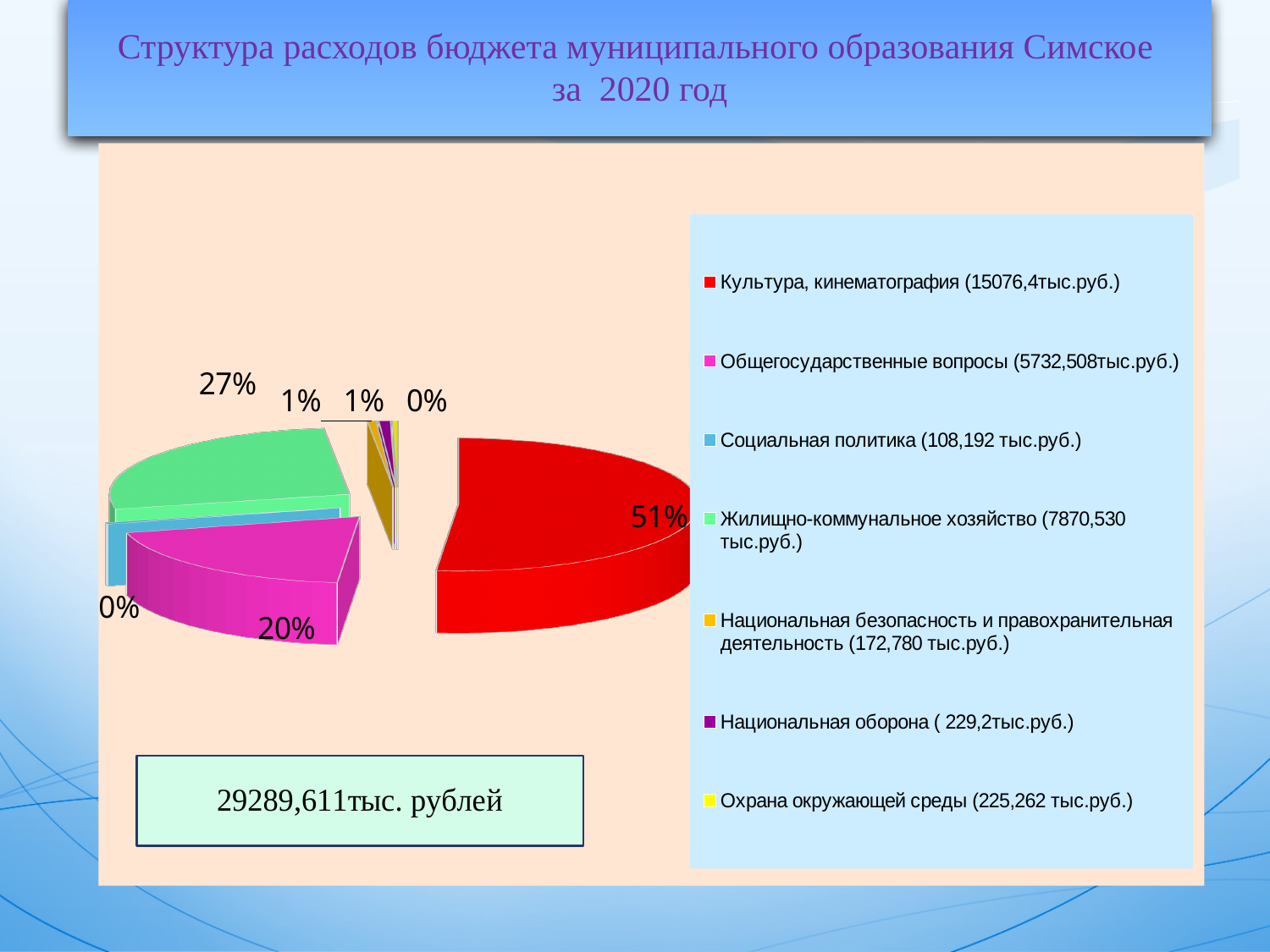
What share of the pie does Жилищно-коммунальное хозяйство have? 27% What kind of chart is shown on the slide? pie chart What is the difference in percentage points between the Культура, кинематография slice and the Жилищно-коммунальное хозяйство slice? 24% What share of the pie does Культура, кинематография have? 51% What amount is given in the legend for Культура, кинематография? 15076,4тыс.руб. Which category has the largest slice of the pie? Культура, кинематография What share of the pie does Общегосударственные вопросы have? 20% How many categories does the legend list? 7 Which slice is larger: Жилищно-коммунальное хозяйство or Общегосударственные вопросы? Жилищно-коммунальное хозяйство What share of the pie does Социальная политика have? 0% What is the difference in percentage points between the Жилищно-коммунальное хозяйство slice and the Общегосударственные вопросы slice? 7% What total amount is shown in the box below the pie chart? 29289,611тыс. рублей